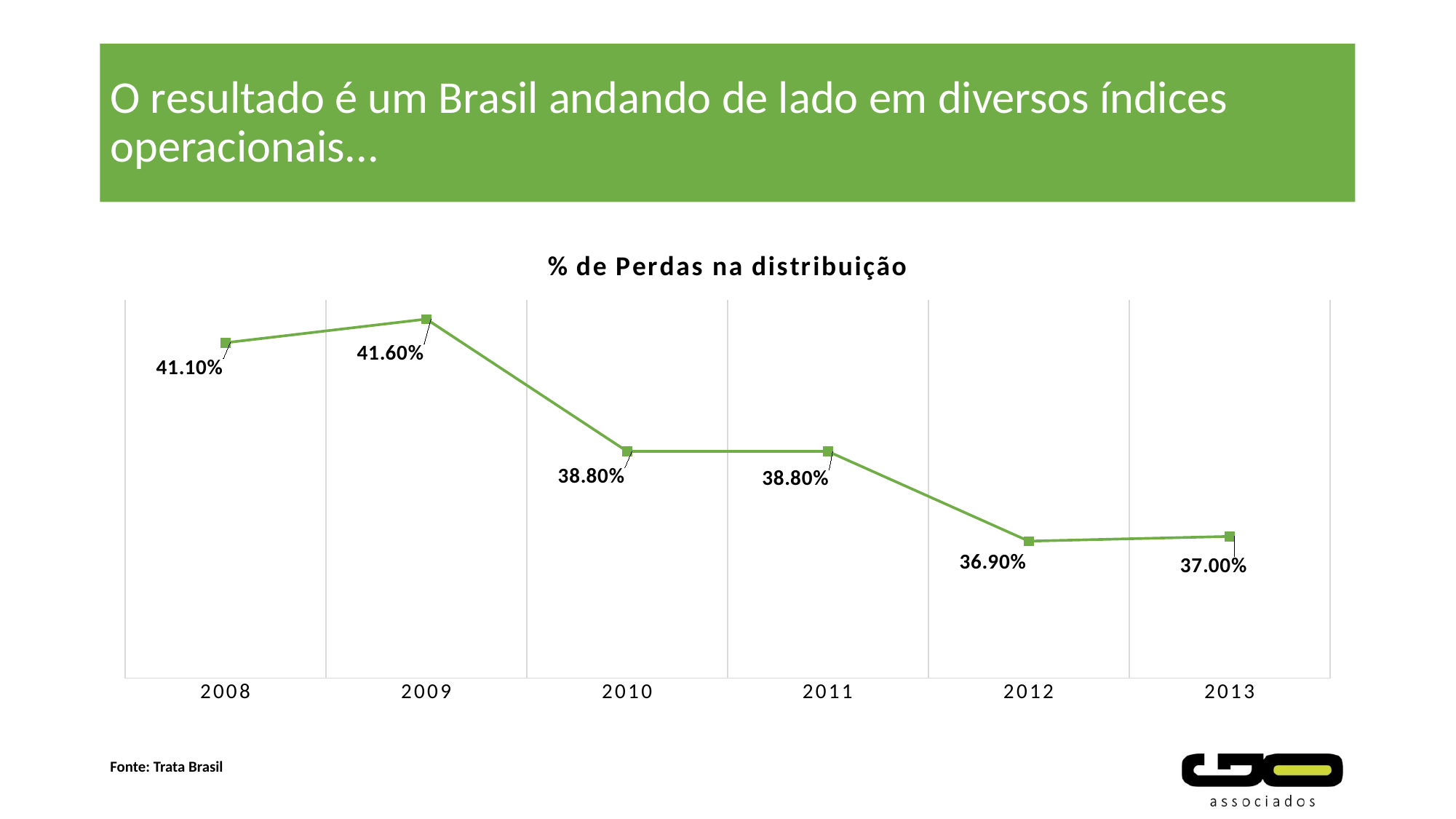
What is the value for 2012? 36.90% What is the value for 2008? 41.10% What is the difference between the values for 2008 and 2010? 2.30% What is the value for 2013? 37.00% What kind of chart is shown? line chart Which is larger, the value for 2008 or the value for 2012? 2008 What is the value for 2009? 41.60% Which year has the lowest value? 2012 What is the title of the chart? % de Perdas na distribuição Which year has the highest value? 2009 How many years are plotted on the chart? 6 What is the difference between the values for 2009 and 2013? 4.60%